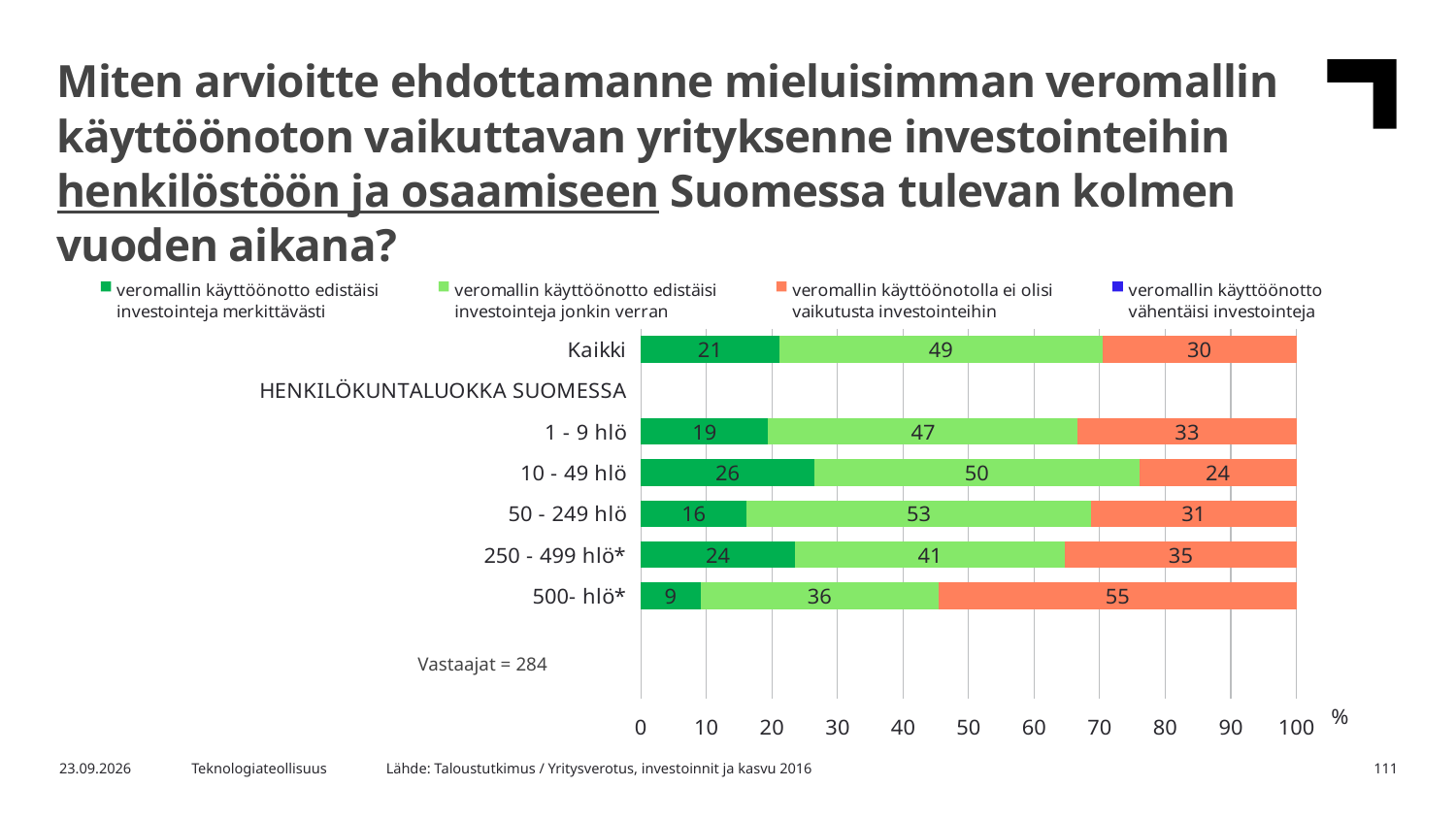
Which is larger: the 'veromallin käyttöönotto edistäisi investointeja jonkin verran' value for '1 - 9 hlö' or for '250 - 499 hlö*'? 1 - 9 hlö How many respondents (Vastaajat) are stated on the slide? 284 Which category has the highest value for 'veromallin käyttöönotto edistäisi investointeja merkittävästi'? 10 - 49 hlö What kind of chart is shown on the slide? Stacked bar chart What is the value for 'veromallin käyttöönotolla ei olisi vaikutusta investointeihin' in the '500- hlö*' bar? 55 What is the total of the stacked bar for '250 - 499 hlö*'? 100 How many bars with data are plotted in the chart? 6 Which category has the lowest value for 'veromallin käyttöönotto edistäisi investointeja merkittävästi'? 500- hlö* How many series does the legend list? 4 What is the value for 'veromallin käyttöönotto edistäisi investointeja jonkin verran' in the '50 - 249 hlö' bar? 53 What is the value for 'veromallin käyttöönotto edistäisi investointeja merkittävästi' in the 'Kaikki' bar? 21 What is the difference between the 'veromallin käyttöönotolla ei olisi vaikutusta investointeihin' values for '500- hlö*' and '10 - 49 hlö'? 31